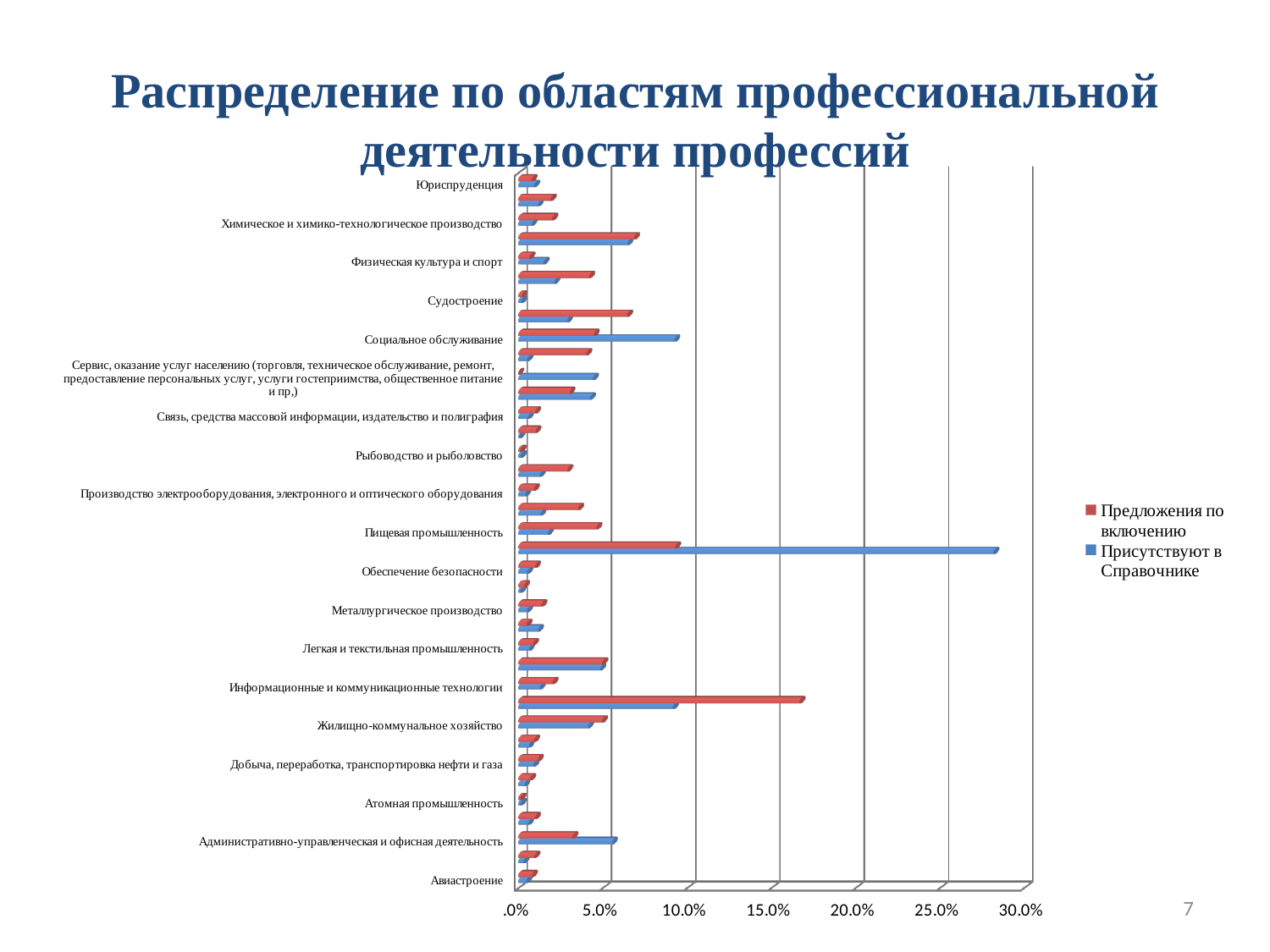
Is the value of 'Присутствуют в Справочнике' for Судостроение greater or less than 5.0%? less What is the highest value shown on the horizontal axis? 30.0% How many series does the legend list? 2 For Социальное обслуживание, which series has the larger value: 'Предложения по включению' or 'Присутствуют в Справочнике'? Присутствуют в Справочнике For Административно-управленческая и офисная деятельность, which series has the larger value? Присутствуют в Справочнике What kind of chart is shown on the slide? Bar chart Is the longest bar in the chart greater or less than 25.0%? greater Which series contains the longest bar in the chart? Присутствуют в Справочнике For Пищевая промышленность, which series has the larger value: 'Предложения по включению' or 'Присутствуют в Справочнике'? Предложения по включению Is the value of 'Присутствуют в Справочнике' for Социальное обслуживание greater or less than 5.0%? greater What are the two series named in the legend? Предложения по включению; Присутствуют в Справочнике